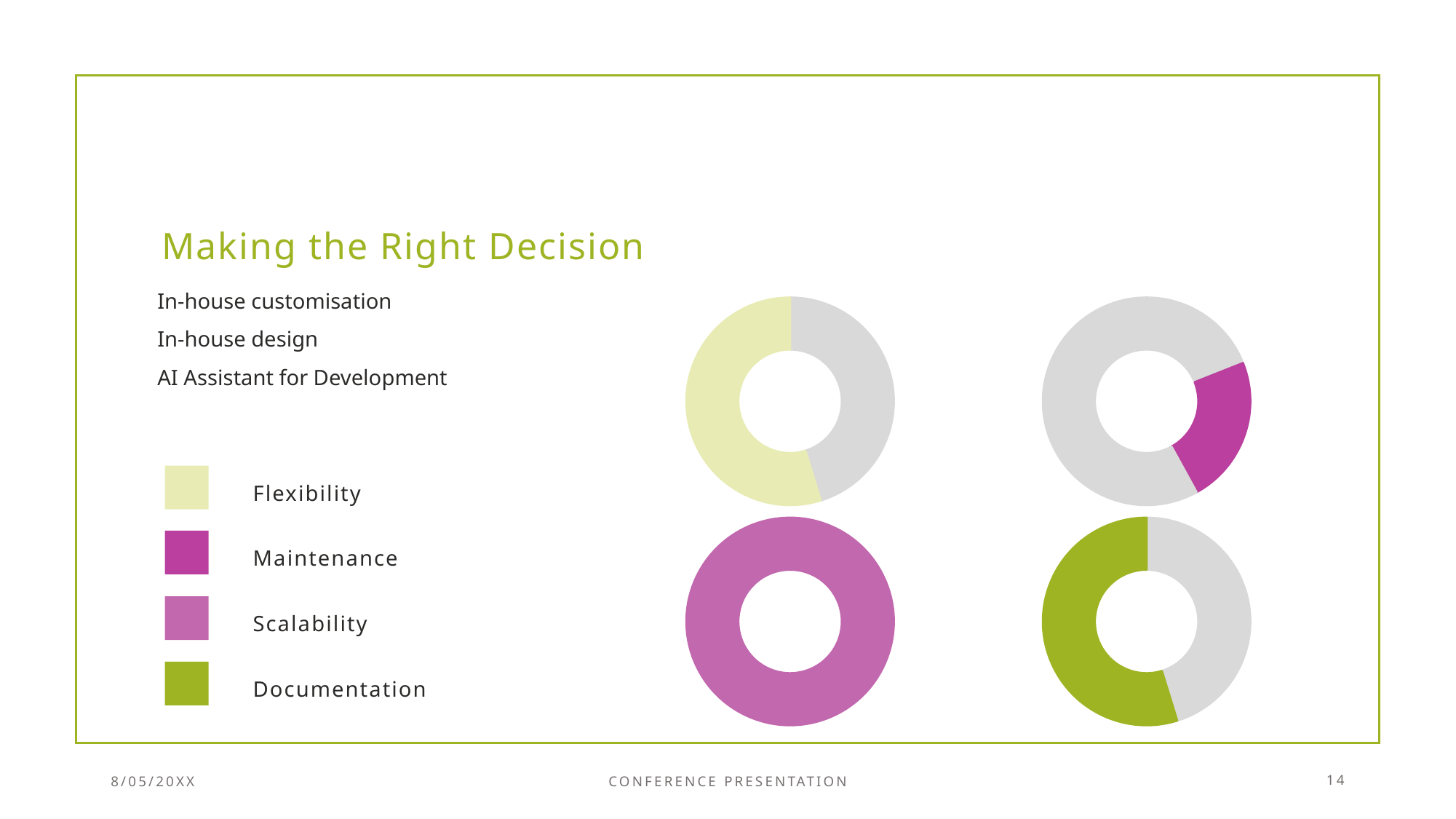
Which has the larger filled share: the Flexibility donut or the Maintenance donut? Flexibility What is the title of the slide containing the four donut charts? Making the Right Decision Which legend entry is shown in dark magenta? Maintenance Which of the four donut charts has the smallest filled share? Maintenance (top-right) Which has the larger filled share: the Scalability donut or the Maintenance donut? Scalability How many donut charts are shown on the slide? 4 What kind of chart is used for the four charts on the right of the slide? Donut (pie) chart How many entries does the legend on the left of the slide list? 4 Which legend entry corresponds to the bottom-left donut chart that is completely filled? Scalability Which has the larger filled share: the Documentation donut or the Maintenance donut? Documentation